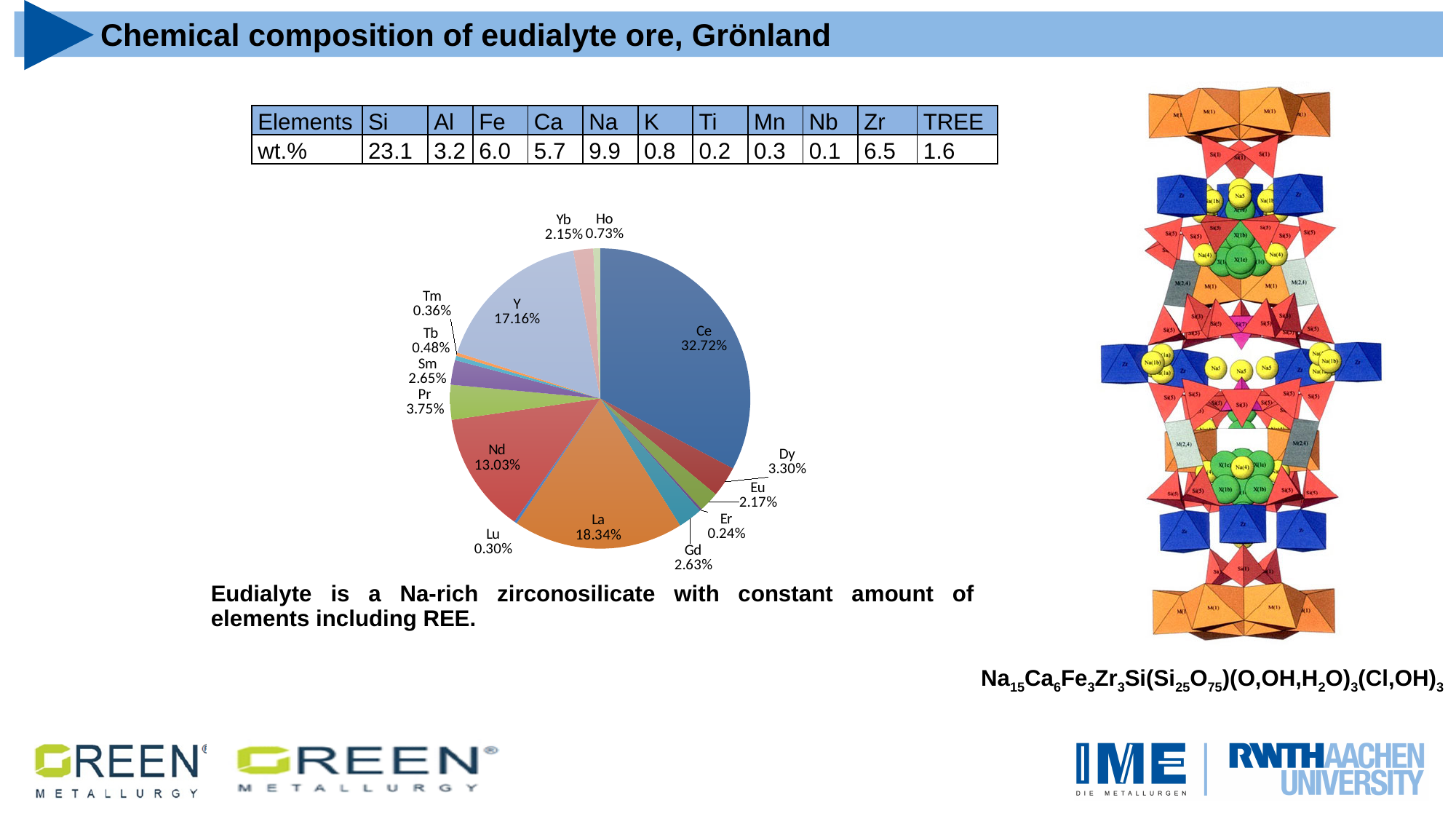
Which element has the largest slice of the pie chart? Ce What is the value shown for Y in the pie chart? 17.16% What is the value shown for Nd in the pie chart? 13.03% What is the difference between the Ce and La shares in the pie chart? 14.38% Which is larger in the pie chart, La or Y? La What kind of chart is shown on the slide? pie chart What is the value shown for La in the pie chart? 18.34% Which element has the smallest slice of the pie chart? Er How many slices does the pie chart have? 15 What is the value shown for Gd in the pie chart? 2.63% What is the difference between the Dy and Eu shares in the pie chart? 1.13% What share of the pie does Ce have? 32.72%